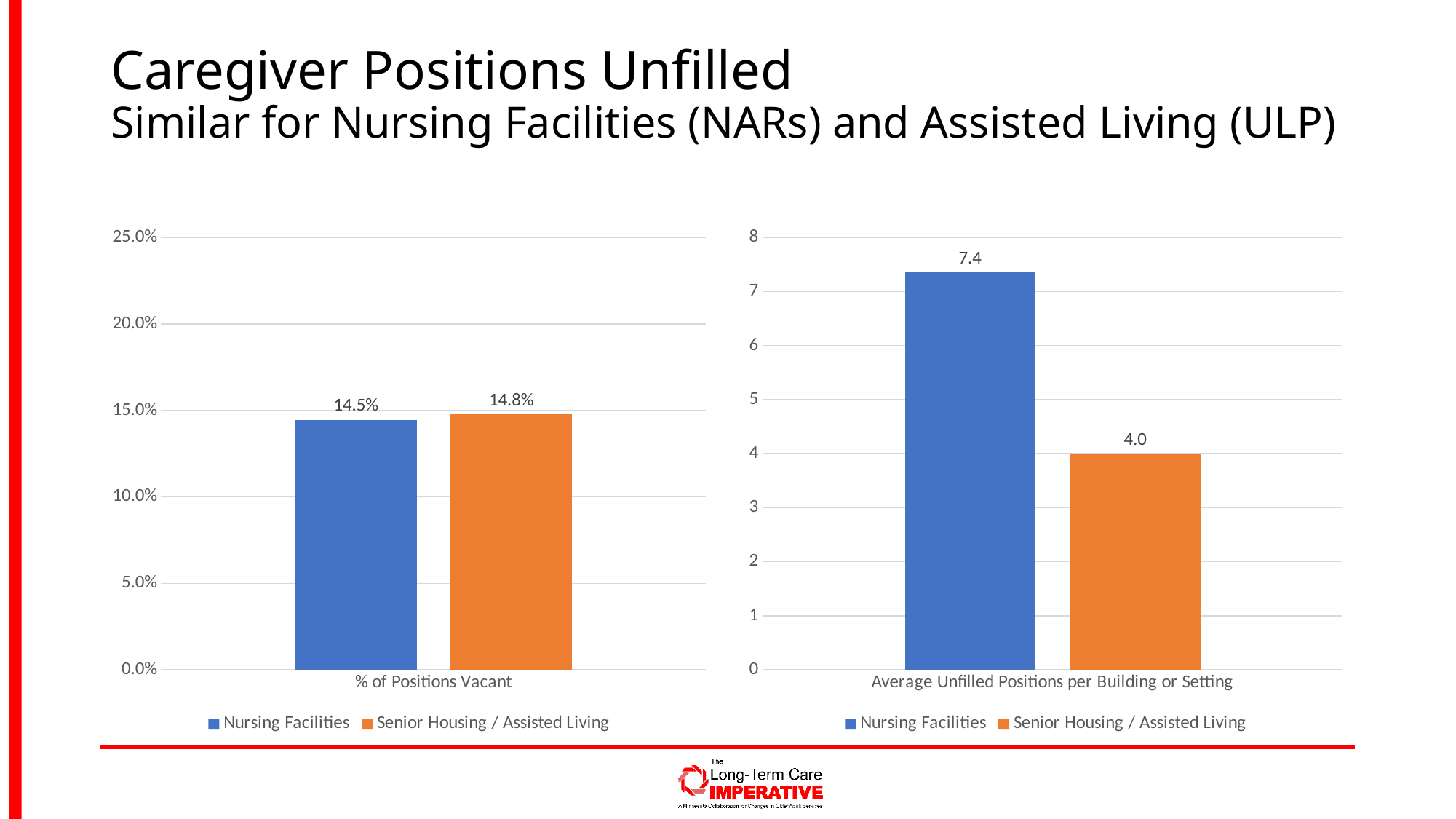
In the right chart (Average Unfilled Positions per Building or Setting), what is the difference between the Nursing Facilities and Senior Housing / Assisted Living values? 3.4 In the left chart (% of Positions Vacant), what is the difference between the Senior Housing / Assisted Living and Nursing Facilities values? 0.3% How many series does the legend of the left chart (% of Positions Vacant) list? 2 In the left chart (% of Positions Vacant), is the value for Nursing Facilities greater or less than 10.0%? greater In the left chart (% of Positions Vacant), what is the value for Nursing Facilities? 14.5% In the left chart (% of Positions Vacant), what colour is the bar for Senior Housing / Assisted Living? orange In the right chart (Average Unfilled Positions per Building or Setting), which series has the higher value? Nursing Facilities In the right chart (Average Unfilled Positions per Building or Setting), what is the value for Nursing Facilities? 7.4 In the right chart (Average Unfilled Positions per Building or Setting), what is the value for Senior Housing / Assisted Living? 4.0 What kind of chart is the right chart (Average Unfilled Positions per Building or Setting)? bar chart In the right chart (Average Unfilled Positions per Building or Setting), is the value for Senior Housing / Assisted Living greater or less than 5? less In the left chart (% of Positions Vacant), what is the value for Senior Housing / Assisted Living? 14.8%